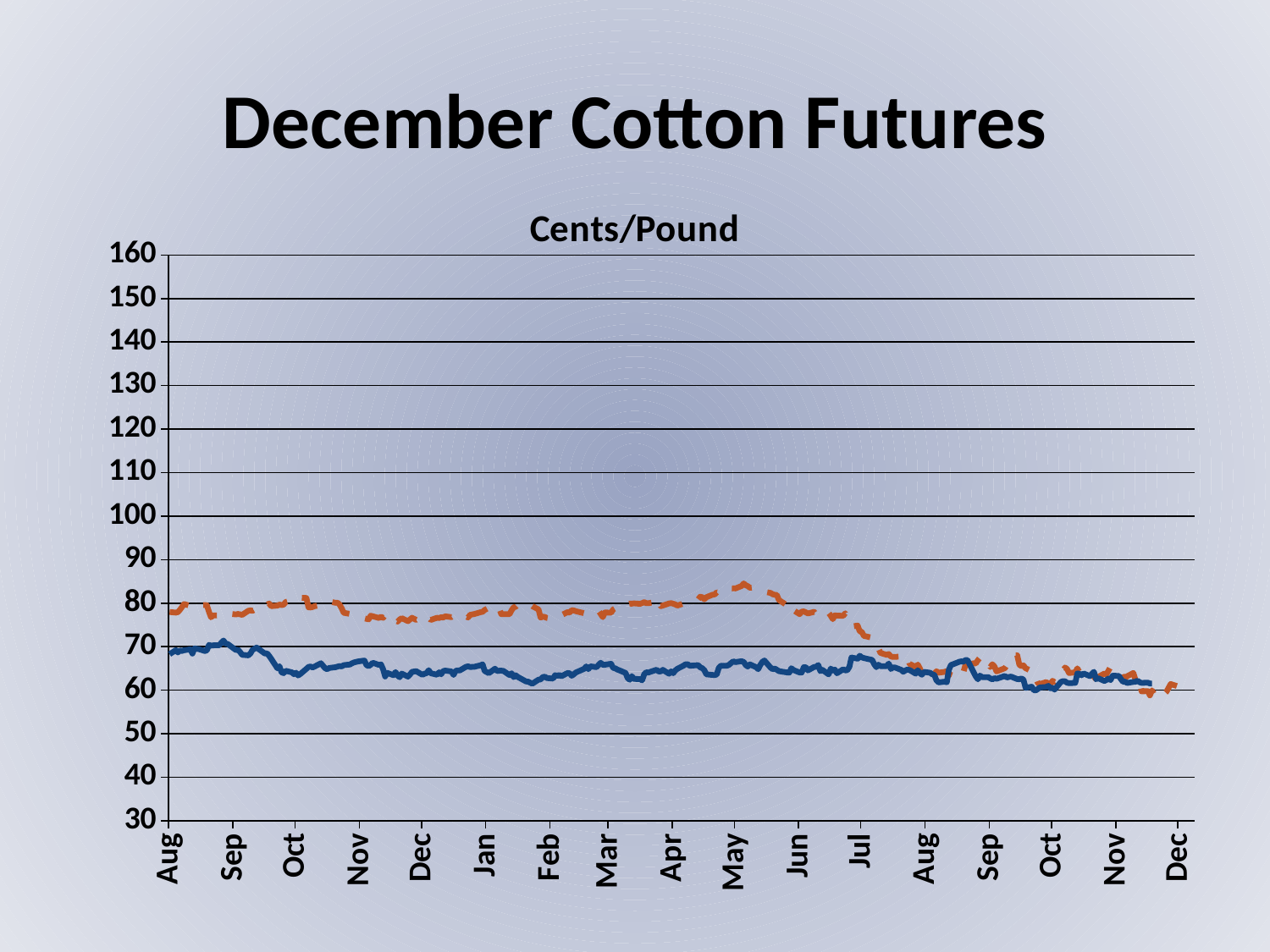
How many lines are plotted on the chart? 2 Is the value of the orange dashed line at the final Dec greater or less than 70? less Is the peak of the orange dashed line around May greater or less than 80? greater Does the orange dashed line rise or fall from May to the final Dec? fall How many month labels are shown along the x axis? 17 At May, which line is higher, the orange dashed line or the blue solid line? orange dashed line Is the value of the blue solid line at Feb greater or less than 70? less What is the title printed above the chart? Cents/Pound What kind of chart is shown on the slide? line chart Which line reaches the highest value anywhere on the chart? orange dashed line What is the highest value shown on the y axis? 160